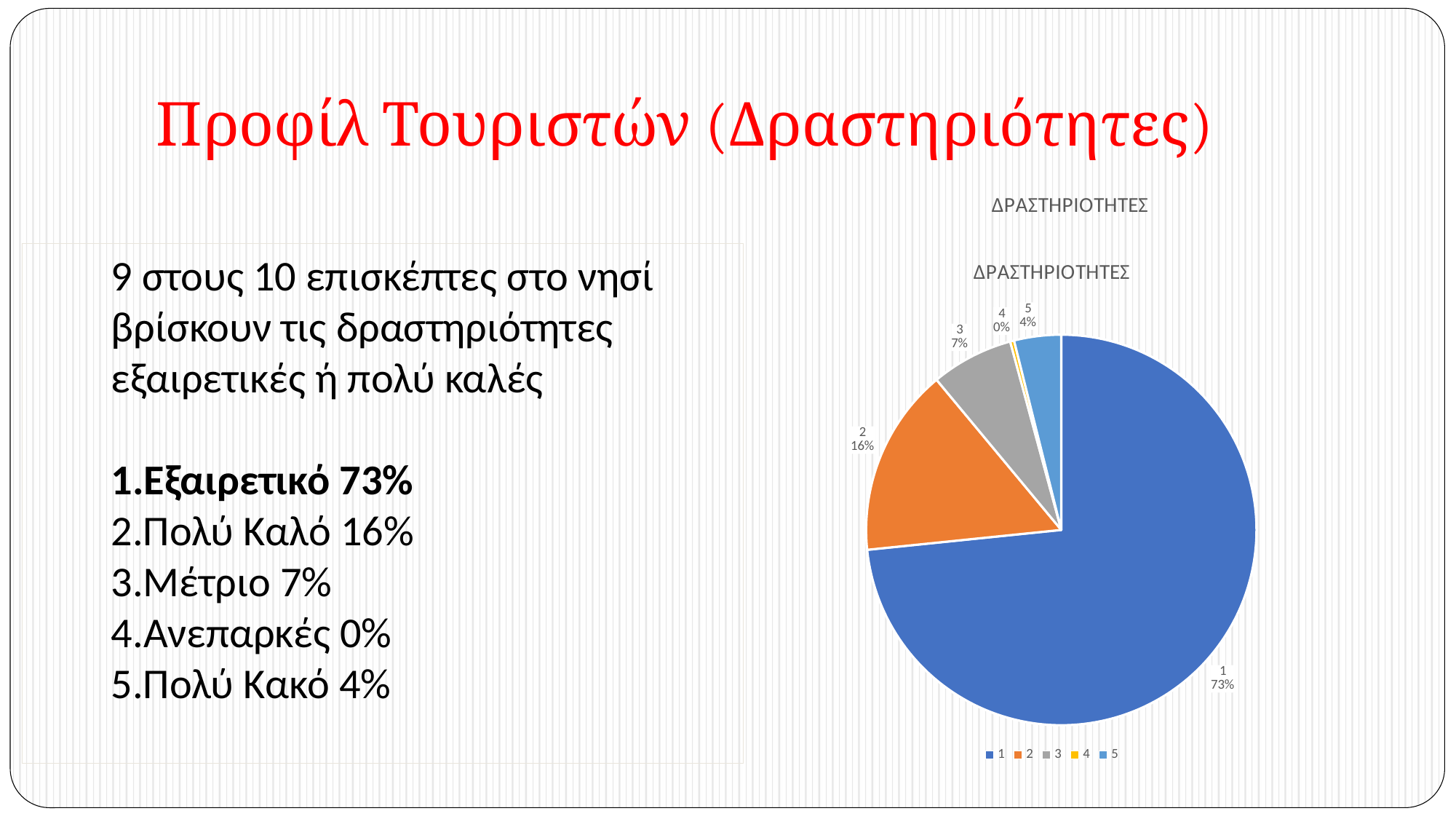
What is the difference in percentage points between slice 1 and slice 2? 57 What colour is slice 2 in the pie chart? orange What percentage does slice 2 represent in the pie chart? 16% Which category has the smallest slice in the pie chart? 4 What type of chart is shown on the slide? pie chart What percentage does slice 1 represent in the pie chart? 73% What percentage does slice 3 represent in the pie chart? 7% Which is larger, slice 3 or slice 5? 3 What is the title of the chart? ΔΡΑΣΤΗΡΙΟΤΗΤΕΣ Which category has the largest slice in the pie chart? 1 What percentage does slice 5 represent in the pie chart? 4% How many categories does the legend of the pie chart list? 5